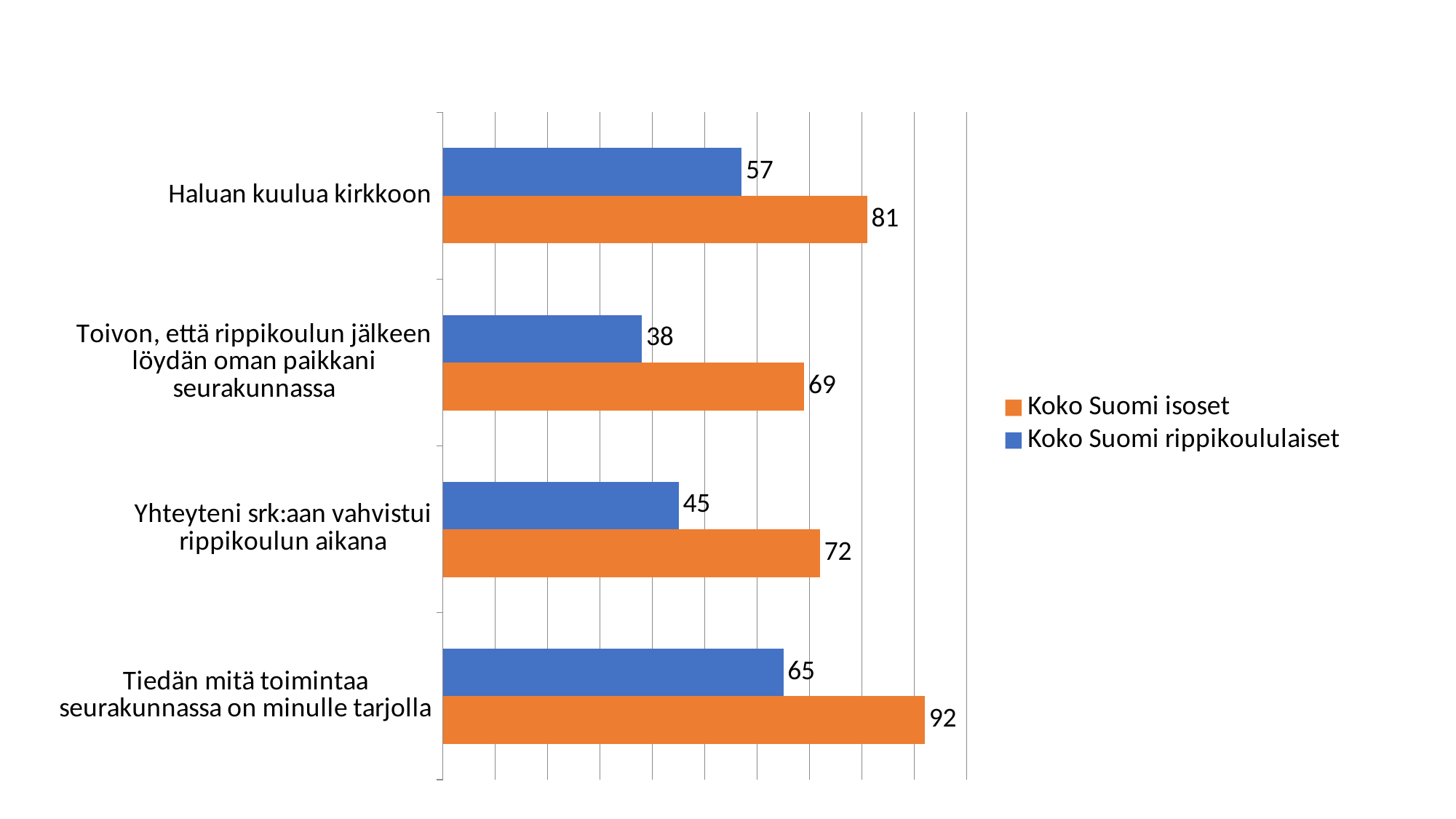
What is the value for "Koko Suomi isoset" for "Haluan kuulua kirkkoon"? 81 Which category has the highest value for "Koko Suomi isoset"? Tiedän mitä toimintaa seurakunnassa on minulle tarjolla What is the value for "Koko Suomi rippikoululaiset" for "Tiedän mitä toimintaa seurakunnassa on minulle tarjolla"? 65 What is the difference between "Koko Suomi isoset" and "Koko Suomi rippikoululaiset" for "Tiedän mitä toimintaa seurakunnassa on minulle tarjolla"? 27 Which is larger for "Haluan kuulua kirkkoon": "Koko Suomi isoset" or "Koko Suomi rippikoululaiset"? Koko Suomi isoset How many categories are shown on the chart? 4 Which colour represents "Koko Suomi isoset" in the chart? Orange What is the value for "Koko Suomi rippikoululaiset" for "Toivon, että rippikoulun jälkeen löydän oman paikkani seurakunnassa"? 38 How many series does the legend list? 2 Which category has the lowest value for "Koko Suomi rippikoululaiset"? Toivon, että rippikoulun jälkeen löydän oman paikkani seurakunnassa What is the difference between "Koko Suomi isoset" and "Koko Suomi rippikoululaiset" for "Yhteyteni srk:aan vahvistui rippikoulun aikana"? 27 What kind of chart is shown on the slide? Bar chart